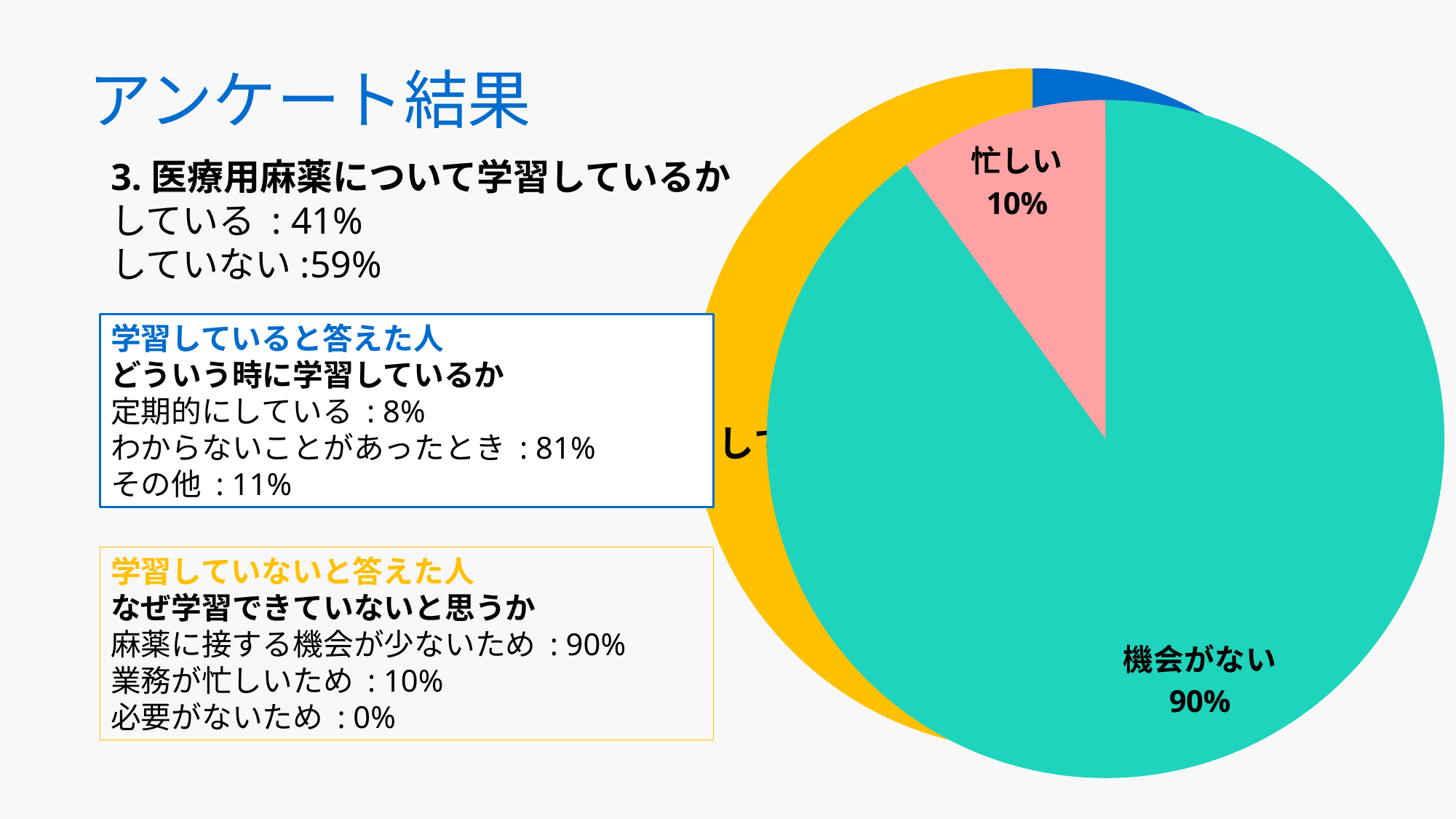
In the front pie chart, what percentage is shown for 機会がない? 90% In the front pie chart, what colour is the 忙しい slice? Pink In the front pie chart, what percentage is shown for 忙しい? 10% In the front pie chart, what colour is the 機会がない slice? Teal (green) In the front pie chart, which slice is the largest? 機会がない In the front pie chart, what share of the pie does 忙しい take? 10% In the front pie chart, what is the difference in percentage points between 機会がない and 忙しい? 80 percentage points What kind of chart is the large chart on the right side of the slide? Pie chart In the front pie chart, which is larger, 機会がない or 忙しい? 機会がない